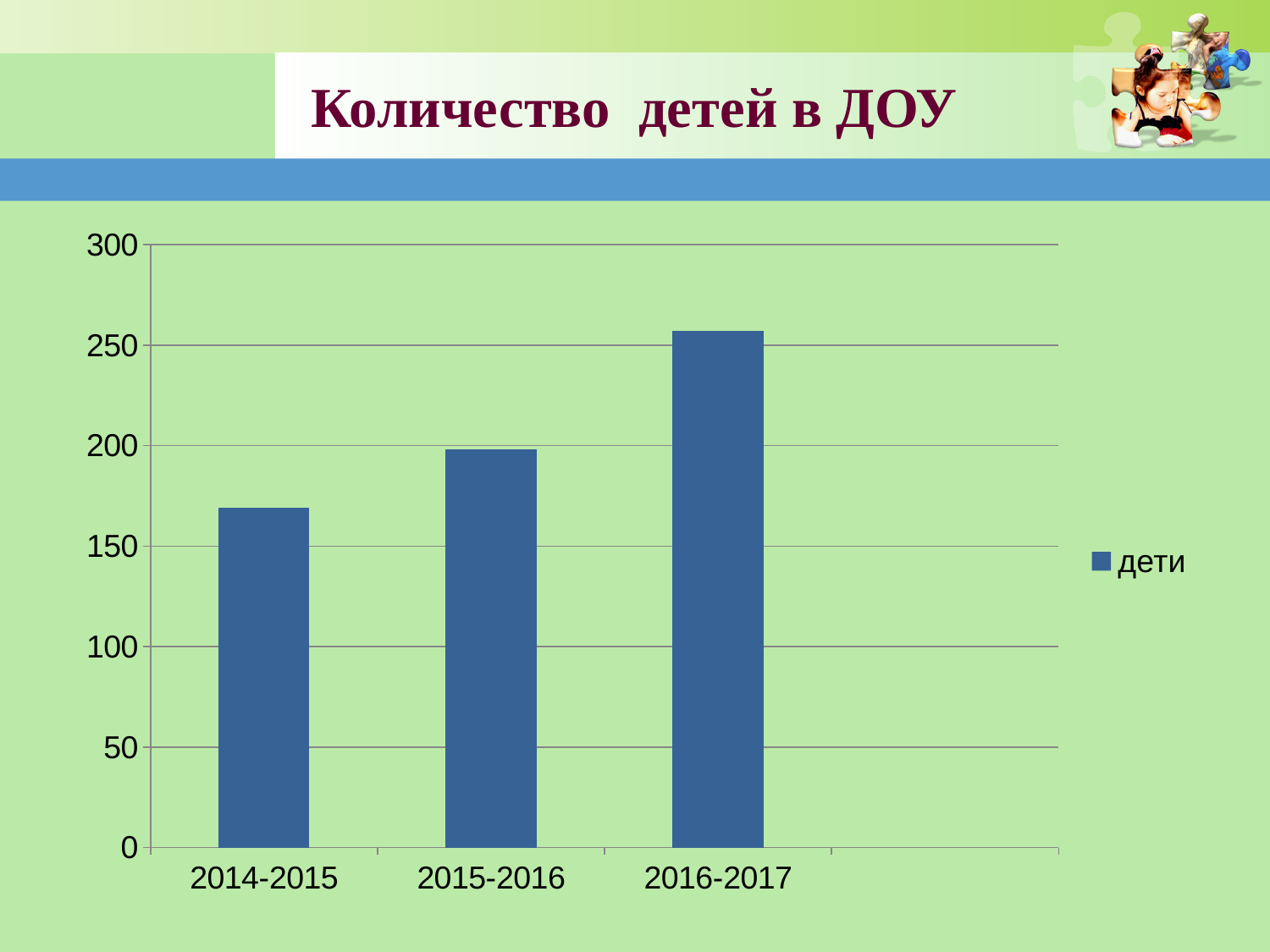
Which academic year has the lowest number of children? 2014-2015 Which is larger, the value for 2016-2017 or the value for 2014-2015? 2016-2017 Do the values rise or fall from 2014-2015 to 2016-2017? rise Which academic year has the highest number of children? 2016-2017 Is the value for 2014-2015 greater or less than 150? greater How many series does the legend list? 1 What kind of chart is shown on the slide? bar chart Is the value for 2014-2015 greater or less than 200? less What is the title of the slide? Количество детей в ДОУ What is the name of the series shown in the legend? дети Is the value for 2016-2017 greater or less than 200? greater How many categories (academic years) are shown on the x axis? 3